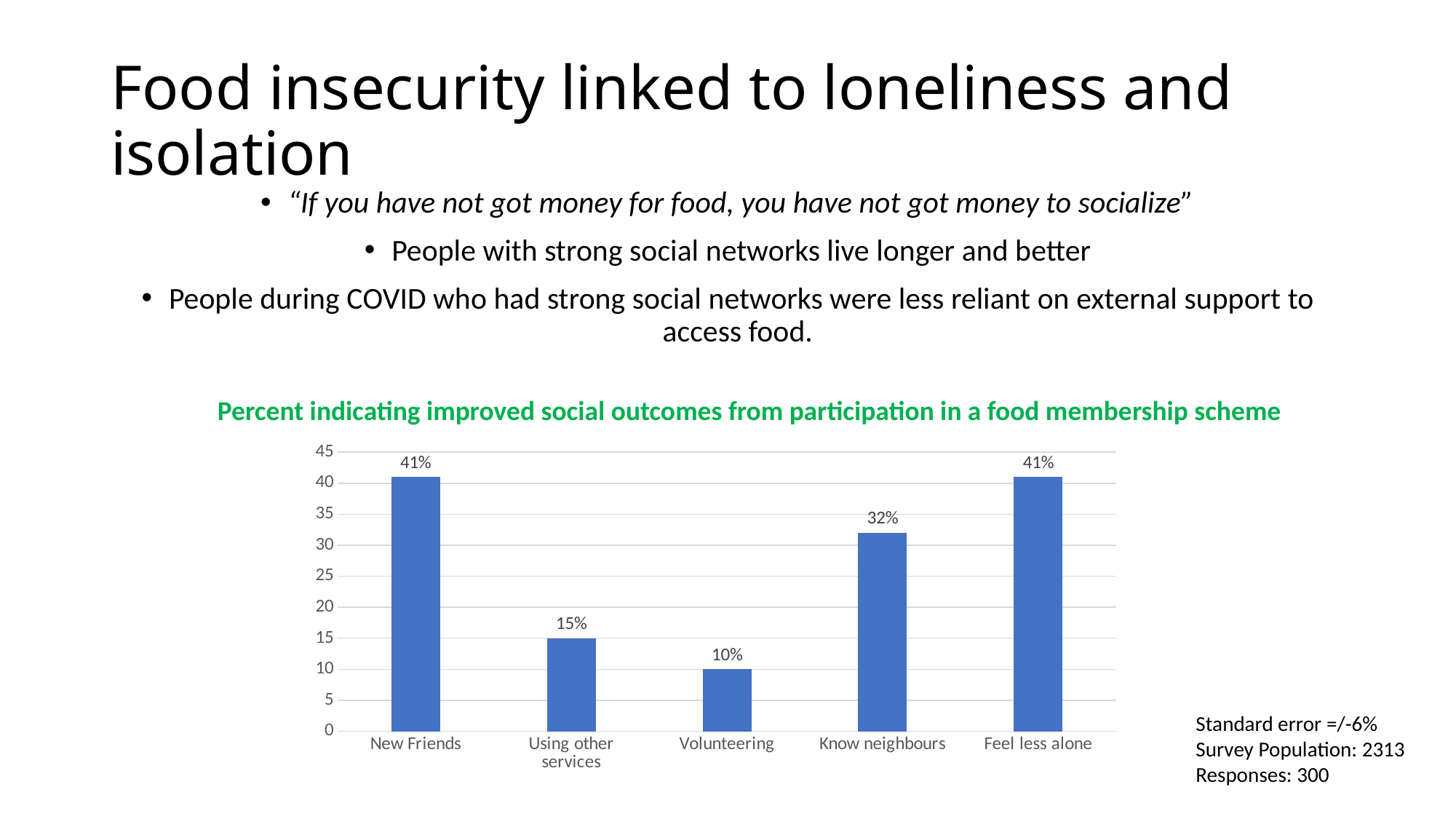
What percentage is shown for Feel less alone? 41% How many categories are shown on the x axis? 5 Is the value for Know neighbours greater or less than 30? greater What kind of chart is shown on the slide? Bar chart What percentage is shown for Volunteering? 10% What is the title of the chart? Percent indicating improved social outcomes from participation in a food membership scheme Which is larger, the value for Know neighbours or the value for Volunteering? Know neighbours What percentage is shown for Know neighbours? 32% What percentage is shown for Using other services? 15% What is the difference between the values for Know neighbours and Using other services? 17% What percentage is shown for New Friends? 41% Which category has the lowest value? Volunteering